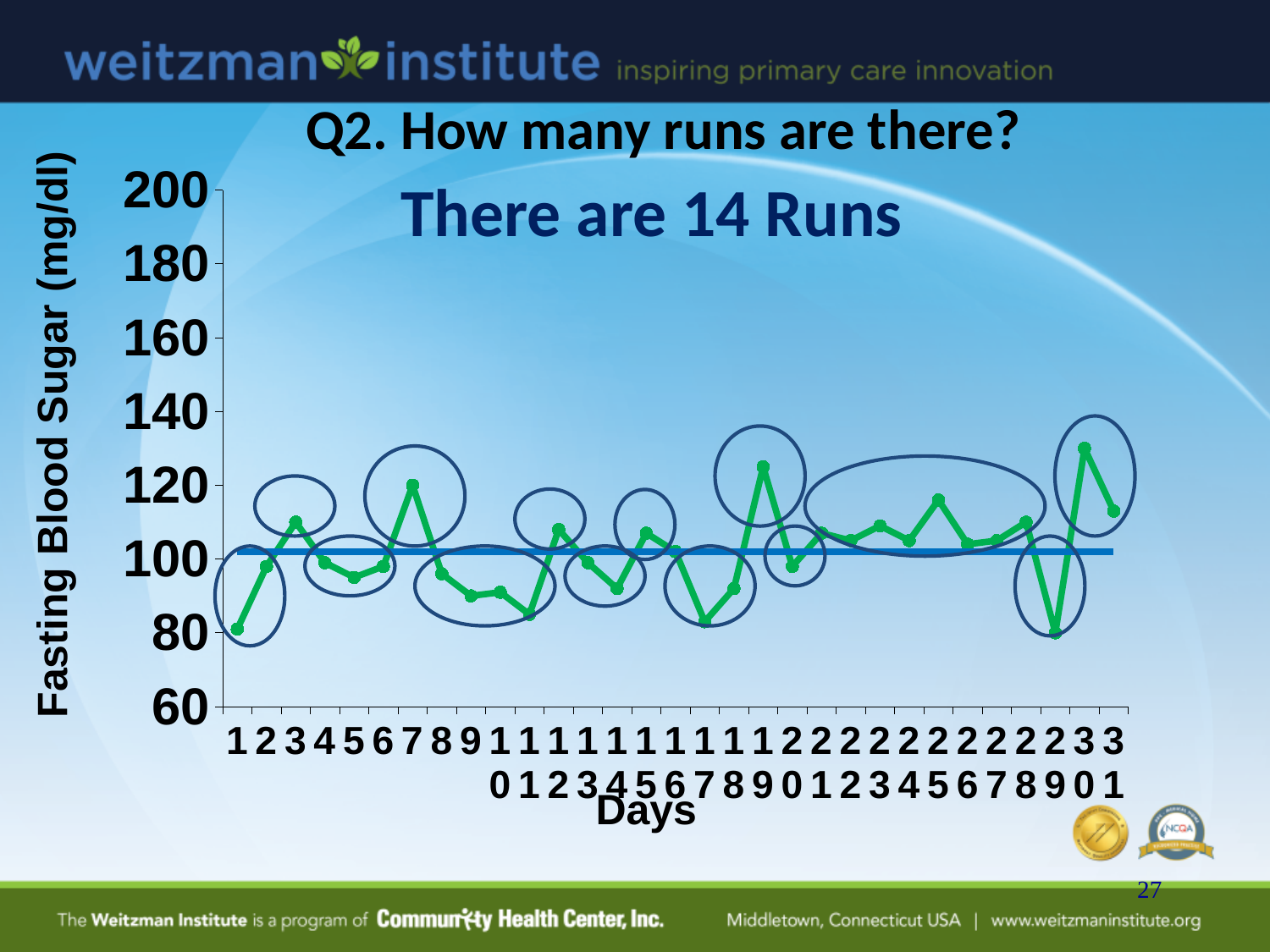
What kind of chart is shown on the slide? line chart Which day has the higher fasting blood sugar value, day 1 or day 7? day 7 What is the title of the vertical axis? Fasting Blood Sugar (mg/dl) Is the fasting blood sugar value for day 19 greater or less than 100? greater Is the fasting blood sugar value for day 17 greater or less than 100? less What is the title of the horizontal axis? Days Is the fasting blood sugar value for day 1 greater or less than 100? less How many days (data points) are plotted on the chart? 31 Which day has the higher fasting blood sugar value, day 29 or day 30? day 30